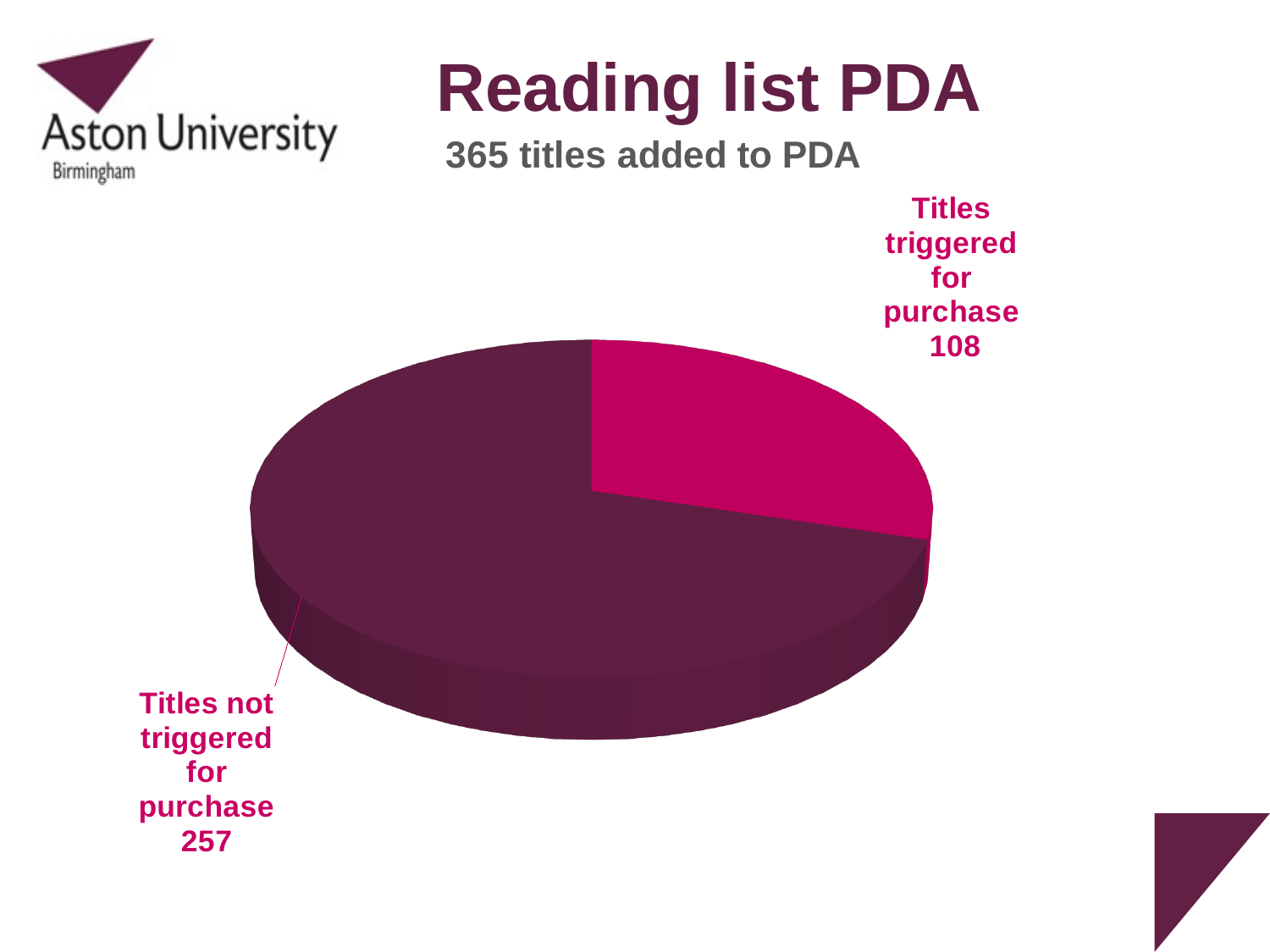
Which is larger, Titles triggered for purchase or Titles not triggered for purchase? Titles not triggered for purchase How many slices does the pie chart have? 2 What is the total of the two slices in the pie chart? 365 Which slice of the pie chart is the smallest? Titles triggered for purchase What is the value for Titles not triggered for purchase? 257 What share of the pie, to one decimal place, is Titles triggered for purchase? 29.6% What is the value for Titles triggered for purchase? 108 What kind of chart is shown on the slide? Pie chart Which slice of the pie chart is the largest? Titles not triggered for purchase What does the subtitle above the pie chart say? 365 titles added to PDA What is the difference between Titles not triggered for purchase and Titles triggered for purchase? 149 What is the title of the slide containing the pie chart? Reading list PDA